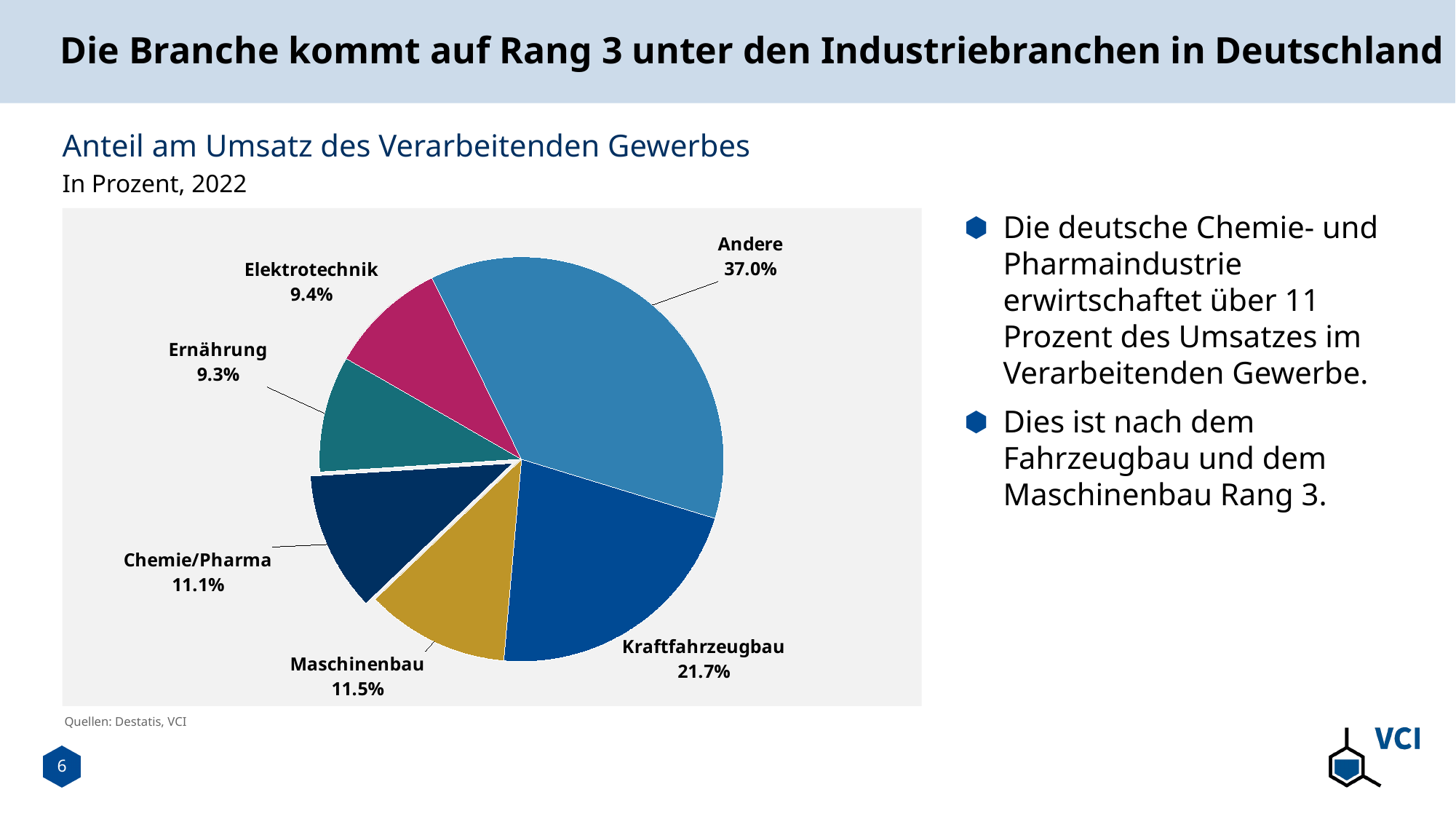
Which year does the chart refer to? 2022 What kind of chart is shown on the slide? Pie chart What is the difference between the shares of Kraftfahrzeugbau and Maschinenbau? 10.2% How many slices does the pie chart have? 6 Which has a larger share, Elektrotechnik or Chemie/Pharma? Chemie/Pharma What share does Chemie/Pharma have in the pie chart? 11.1% What is the difference between the shares of Maschinenbau and Chemie/Pharma? 0.4% What share does Kraftfahrzeugbau have in the pie chart? 21.7% What share does Ernährung have in the pie chart? 9.3% What is the title of the chart? Anteil am Umsatz des Verarbeitenden Gewerbes Which slice of the pie chart is the smallest? Ernährung Which slice of the pie chart is the largest? Andere